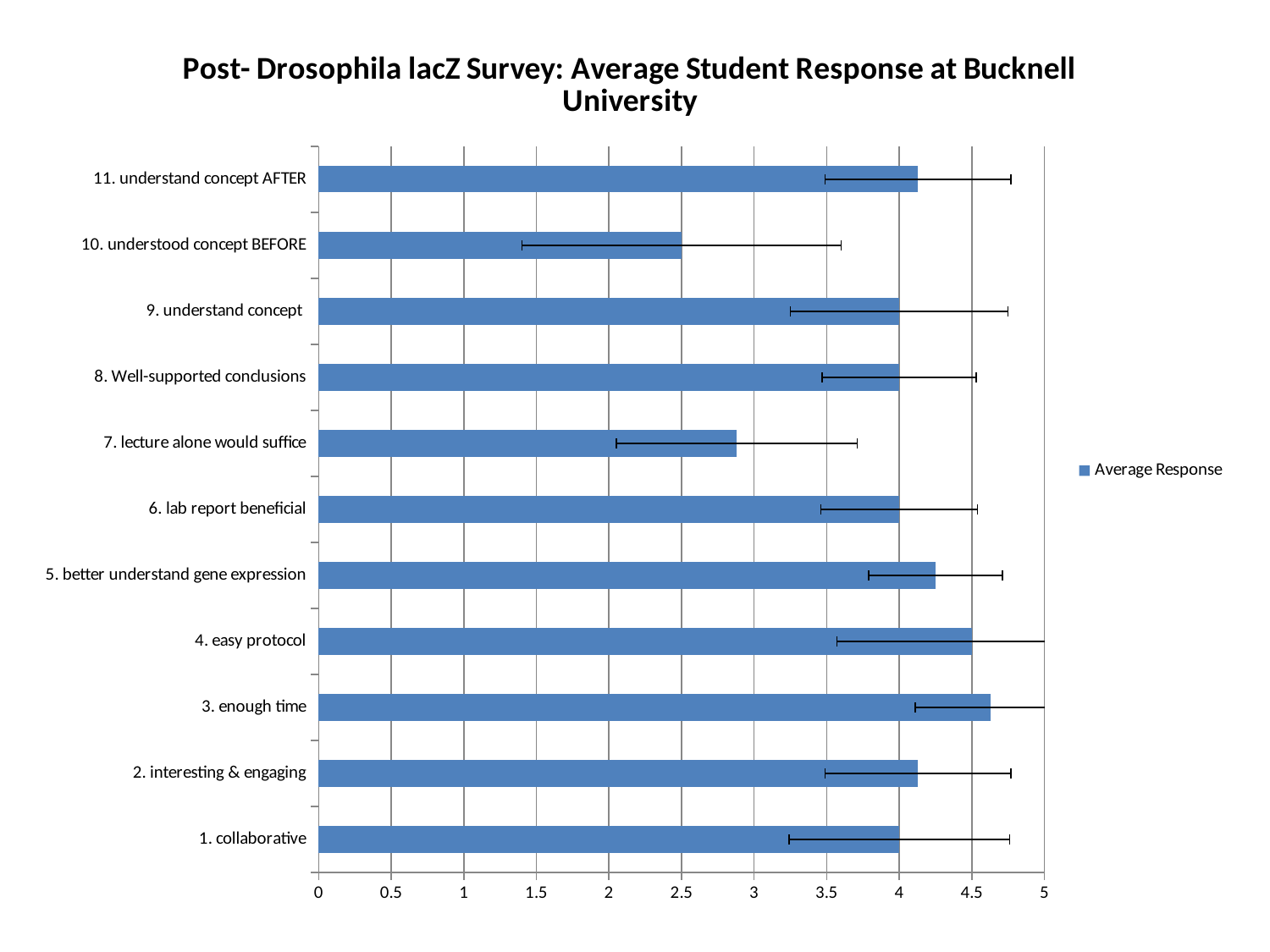
What kind of chart is shown on the slide? bar chart How many categories are plotted in the chart? 11 Which has the larger average response: '7. lecture alone would suffice' or '8. Well-supported conclusions'? 8. Well-supported conclusions How many series does the legend list? 1 Is the value for '5. better understand gene expression' greater or less than 4.5? less What is the name of the series shown in the legend? Average Response What is the title of the chart? Post- Drosophila lacZ Survey: Average Student Response at Bucknell University Which category has the highest average response? 3. enough time Which has the larger average response: '10. understood concept BEFORE' or '11. understand concept AFTER'? 11. understand concept AFTER Is the value for '11. understand concept AFTER' greater or less than 4? greater Which category has the lowest average response? 10. understood concept BEFORE Is the value for '7. lecture alone would suffice' greater or less than 3? less